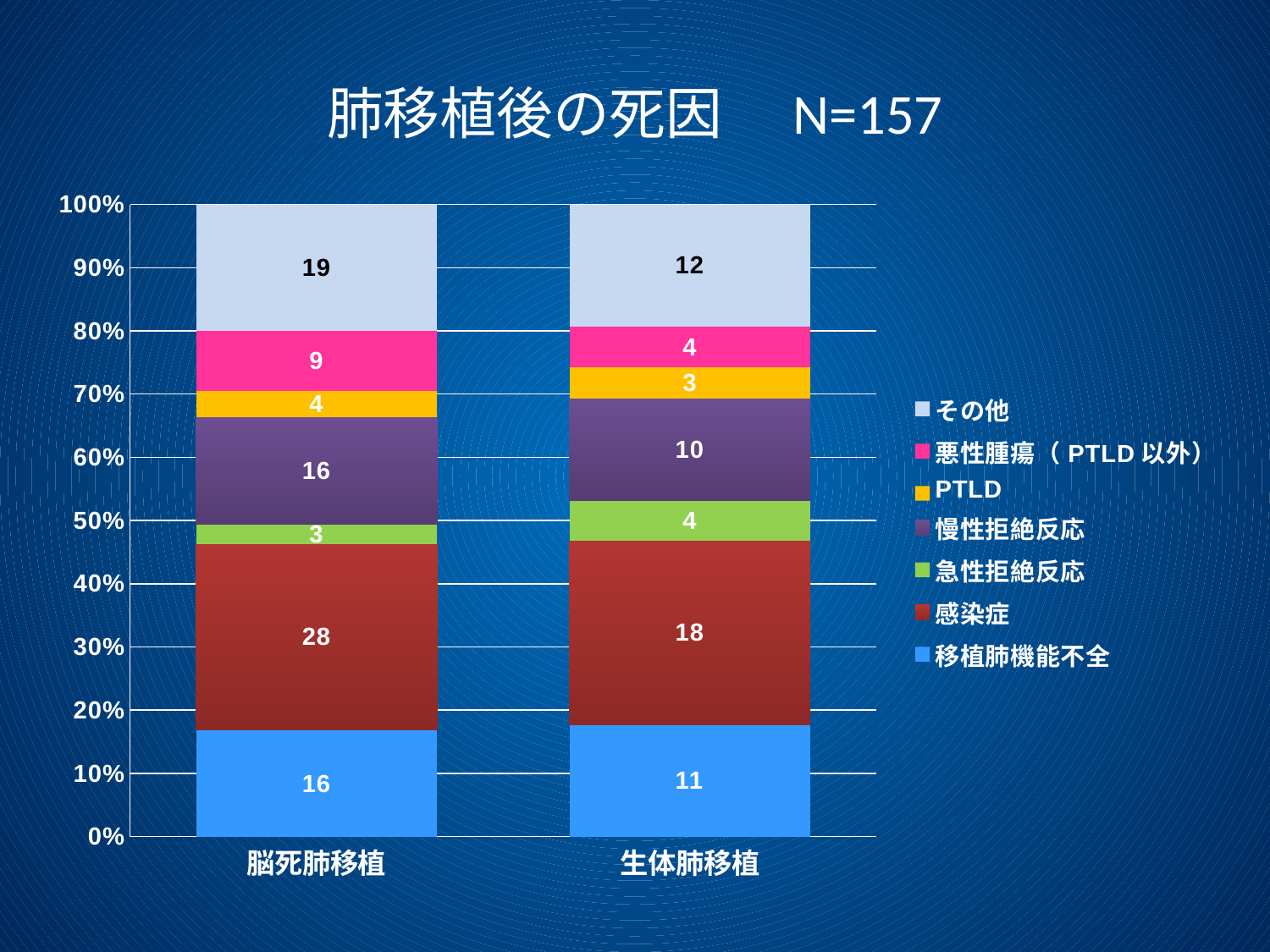
What kind of chart is shown on the slide? Stacked bar chart What is the total of all segments in the 生体肺移植 bar? 62 Which cause of death has the largest value in the 脳死肺移植 bar? 感染症 What is the total of all segments in the 脳死肺移植 bar? 95 What is the value for 移植肺機能不全 in the 脳死肺移植 bar? 16 What is the difference between the 感染症 values for 脳死肺移植 and 生体肺移植? 10 Which cause of death has the smallest value in the 生体肺移植 bar? PTLD What is the value for 感染症 in the 脳死肺移植 bar? 28 How many series does the legend list? 7 Which bar has the larger value for 悪性腫瘍（PTLD以外）, 脳死肺移植 or 生体肺移植? 脳死肺移植 What is the value for その他 in the 生体肺移植 bar? 12 What is the value for 慢性拒絶反応 in the 生体肺移植 bar? 10